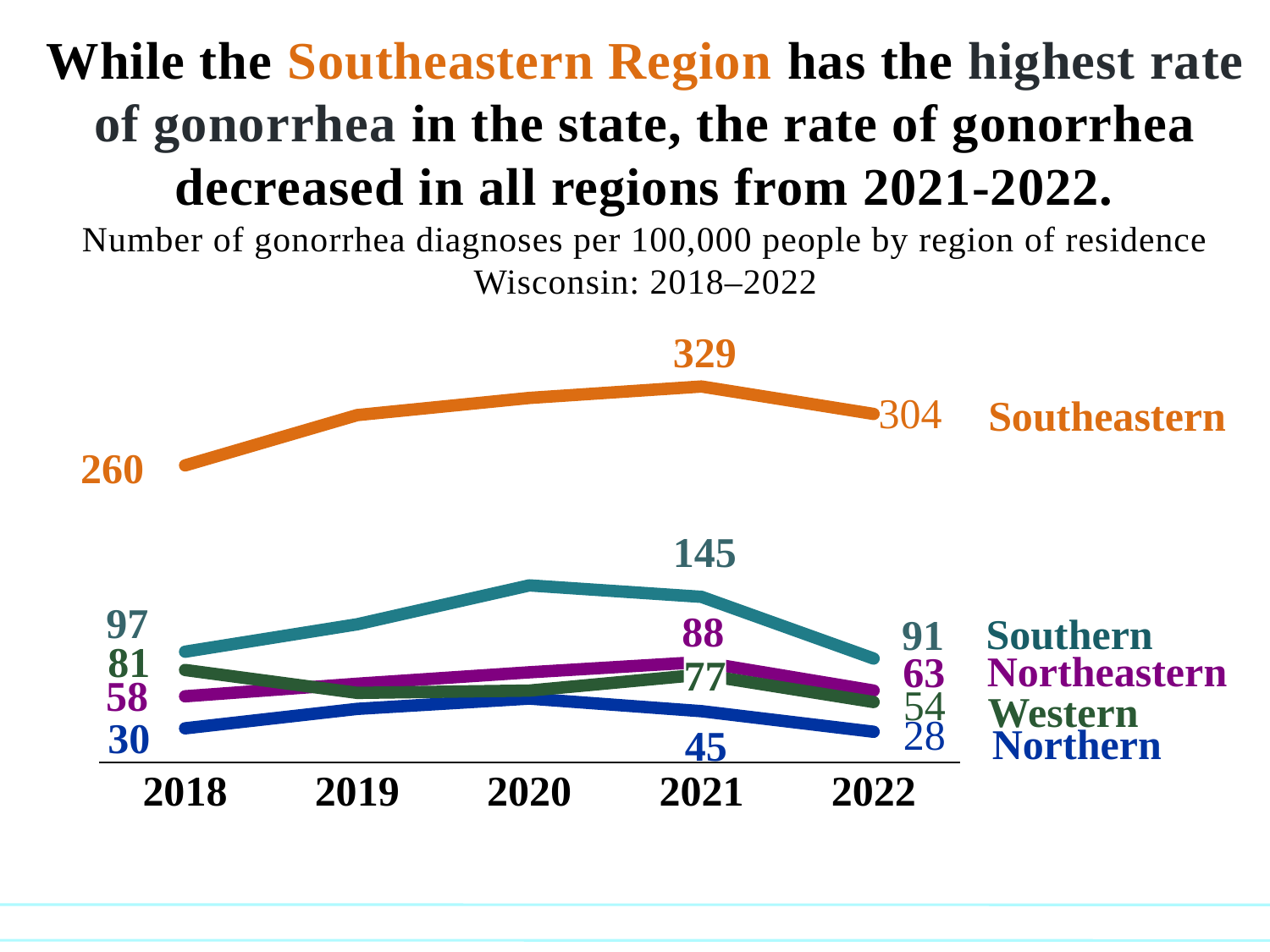
Which region has the lowest value in 2022? Northern What is the value for the Western region in 2018? 81 In 2018, which region had the larger value, Western or Northeastern? Western How many years are shown on the x axis? 5 Which region has the highest value in 2022? Southeastern What is the value for the Southeastern region in 2022? 304 How many regions (series) are plotted on the chart? 5 What kind of chart is shown on the slide? Line chart What is the value for the Northern region in 2022? 28 By how much did the Southeastern region's value decrease from 2021 to 2022? 25 What is the value for the Southeastern region in 2018? 260 What is the difference between the Southern and Northeastern values in 2022? 28